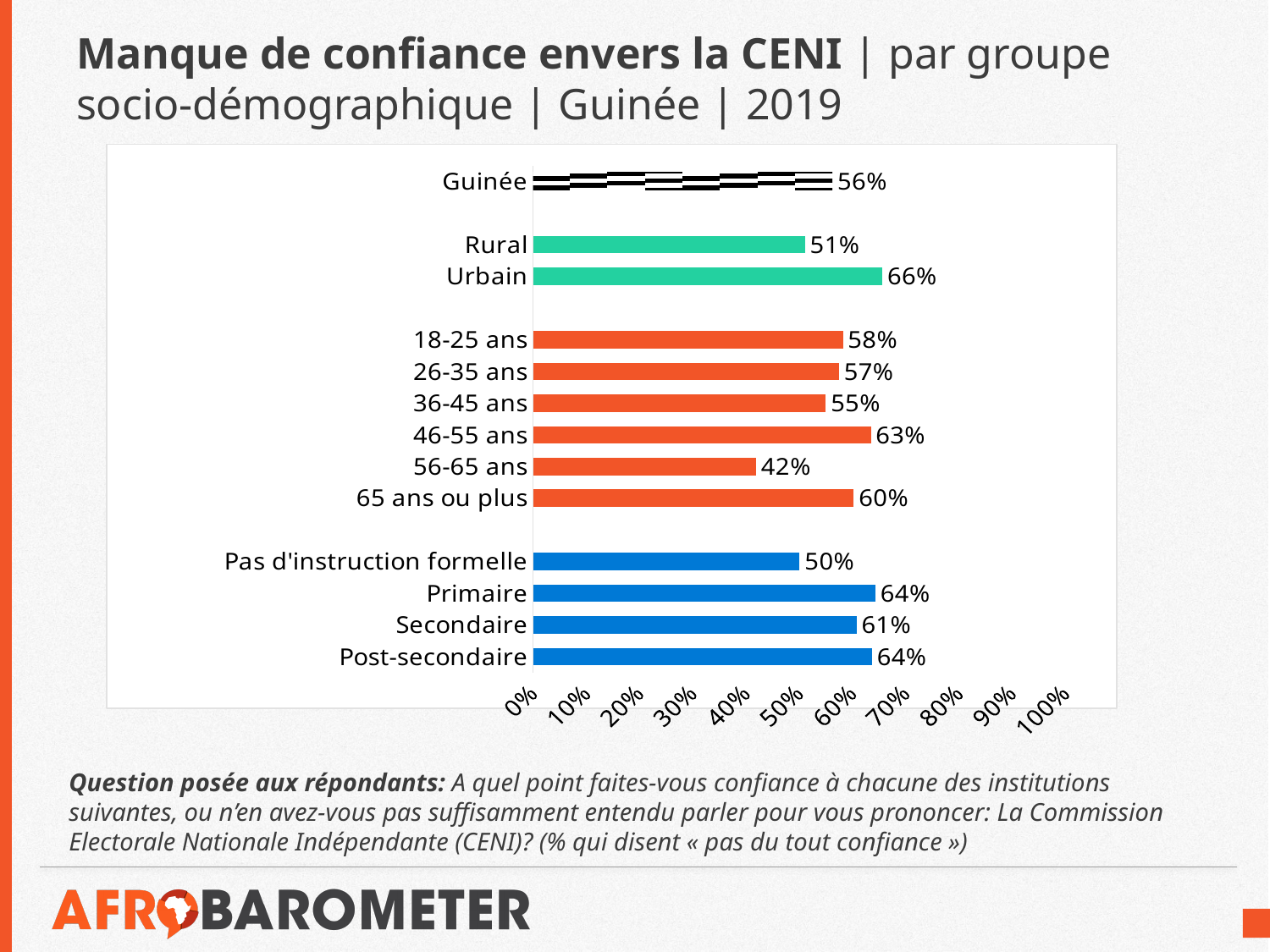
What is the value for 56-65 ans? 42% What is the value for Guinée overall? 56% Which category has the lowest value? 56-65 ans What is the value for Pas d'instruction formelle? 50% What kind of chart is shown? Bar chart What is the highest value shown on the x axis? 100% Which is larger, Primaire or Secondaire? Primaire How many categories are plotted on the chart? 13 What is the difference between 46-55 ans and 56-65 ans? 21% Which category has the highest value? Urbain What is the value for Urbain? 66% What is the difference between Urbain and Rural? 15%